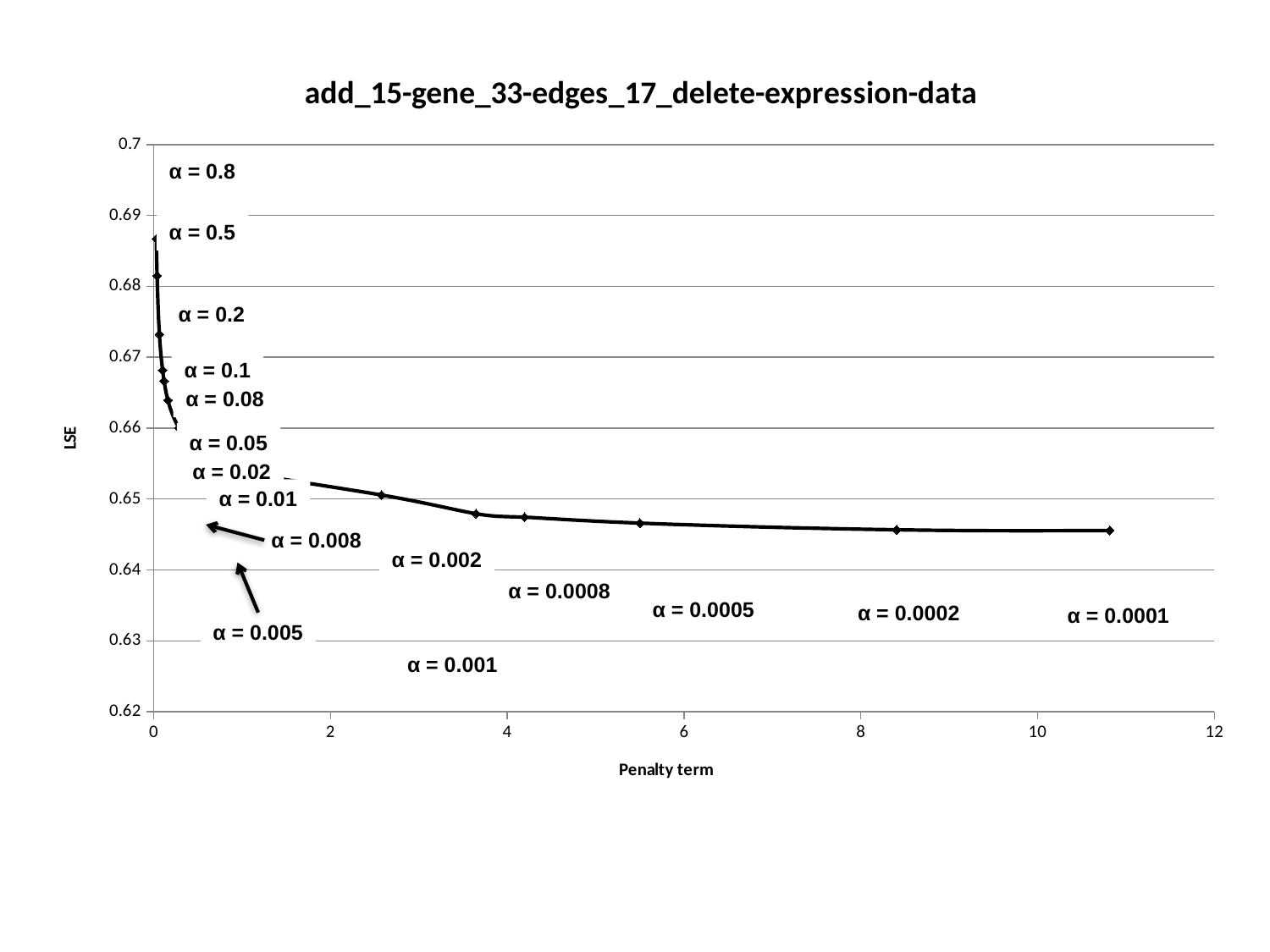
What is the title of the chart? add_15-gene_33-edges_17_delete-expression-data Is the LSE value for the point labelled α = 0.2 greater or less than 0.67? greater What is the label of the x axis? Penalty term Is the LSE value for the point labelled α = 0.8 greater or less than 0.68? greater Is the LSE value for the point labelled α = 0.08 greater or less than 0.67? less As the penalty term increases along the x axis, does LSE rise or fall? fall What kind of chart is shown on the slide? line chart Which labelled point has the highest LSE on the chart? α = 0.8 Which point has the highest LSE, the one labelled α = 0.8 or the one labelled α = 0.0001? α = 0.8